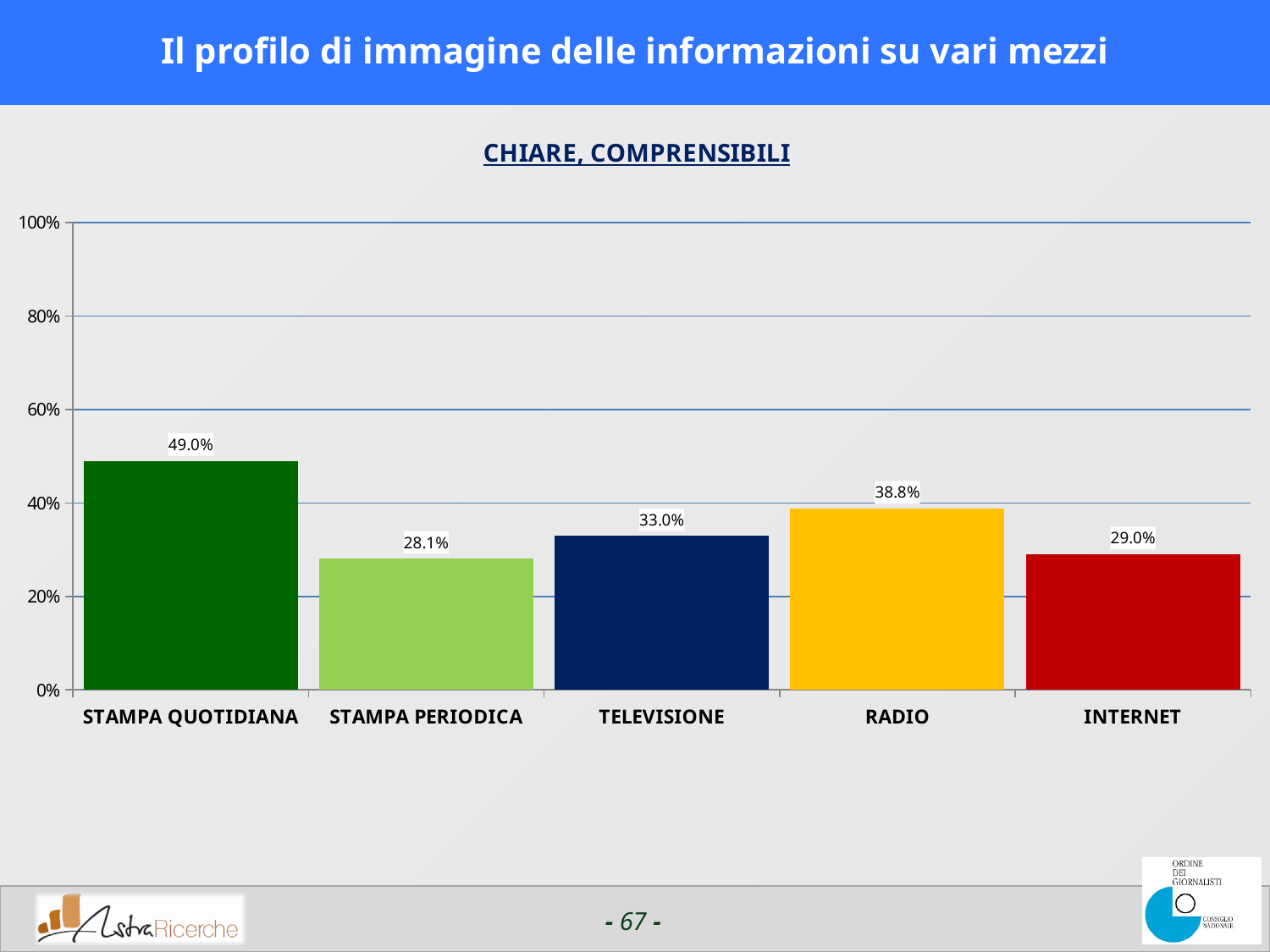
How many categories are shown on the x axis? 5 What is the difference between the values for STAMPA QUOTIDIANA and RADIO? 10.2% Which category has the lowest value? STAMPA PERIODICA Which category has the highest value? STAMPA QUOTIDIANA What is the difference between the values for TELEVISIONE and STAMPA PERIODICA? 4.9% What is the title shown above the chart? CHIARE, COMPRENSIBILI Is the value for RADIO greater or less than 40%? less Which is larger, the value for TELEVISIONE or the value for INTERNET? TELEVISIONE What is the value for STAMPA QUOTIDIANA? 49.0% What kind of chart is shown on the slide? bar chart What is the value for RADIO? 38.8% What is the value for INTERNET? 29.0%